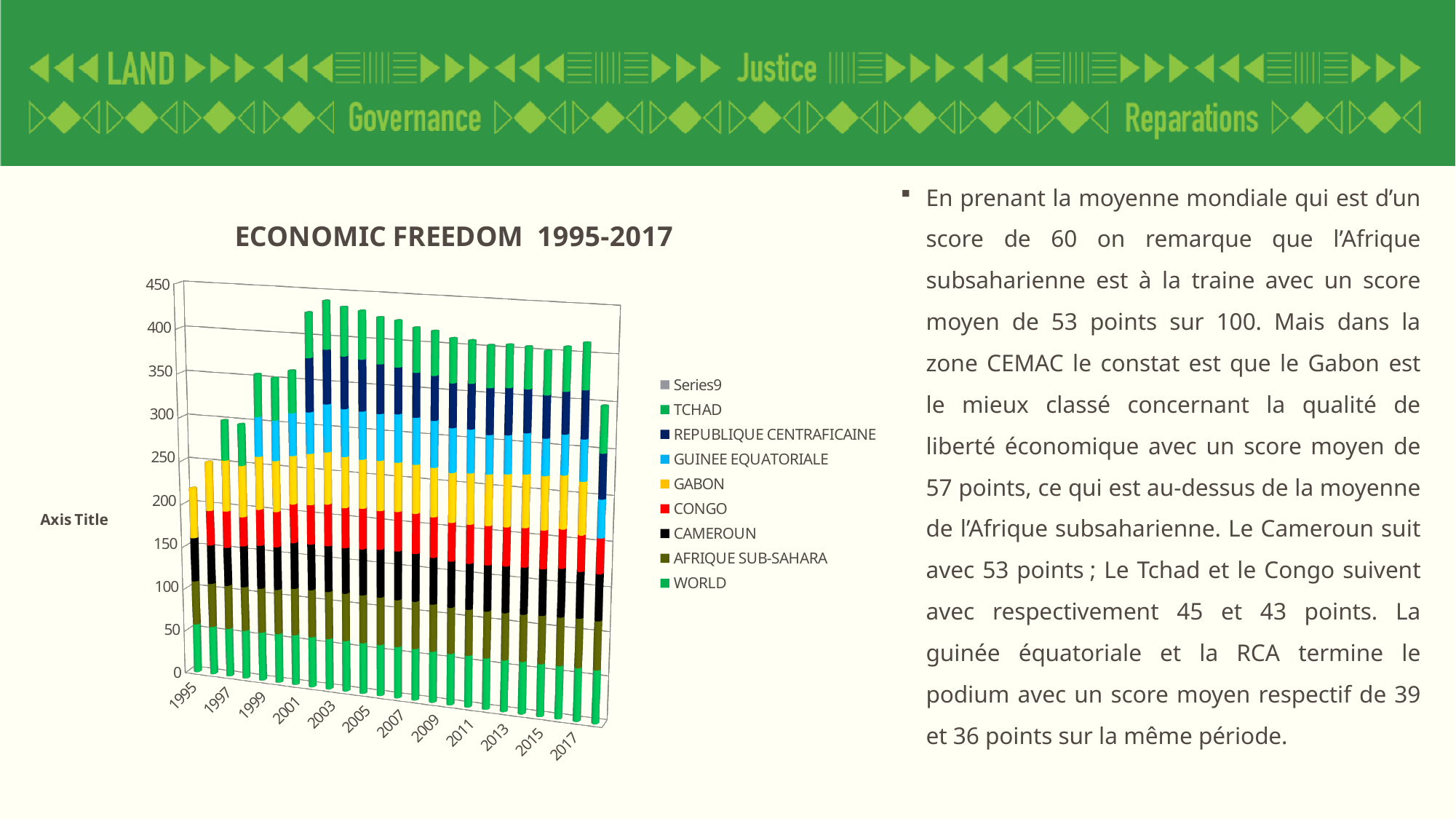
Do the stacked bar totals rise or fall from 2003 to 2016? Fall What is the title of the chart? ECONOMIC FREEDOM 1995-2017 Which year has the shortest stacked bar in the chart? 1995 Which series is shown in red in the chart legend? CONGO Which year has the tallest stacked bar in the chart? 2003 Is the total stacked value for 1995 greater or less than 250? less How many year labels are shown along the x axis of the chart? 12 Is the total stacked value for 2017 greater or less than 350? greater What kind of chart is shown on the slide? Stacked bar chart Which year has a taller stacked bar, 2003 or 2017? 2003 Is the total stacked value for 2003 greater or less than 400? greater How many series does the chart legend list? 9